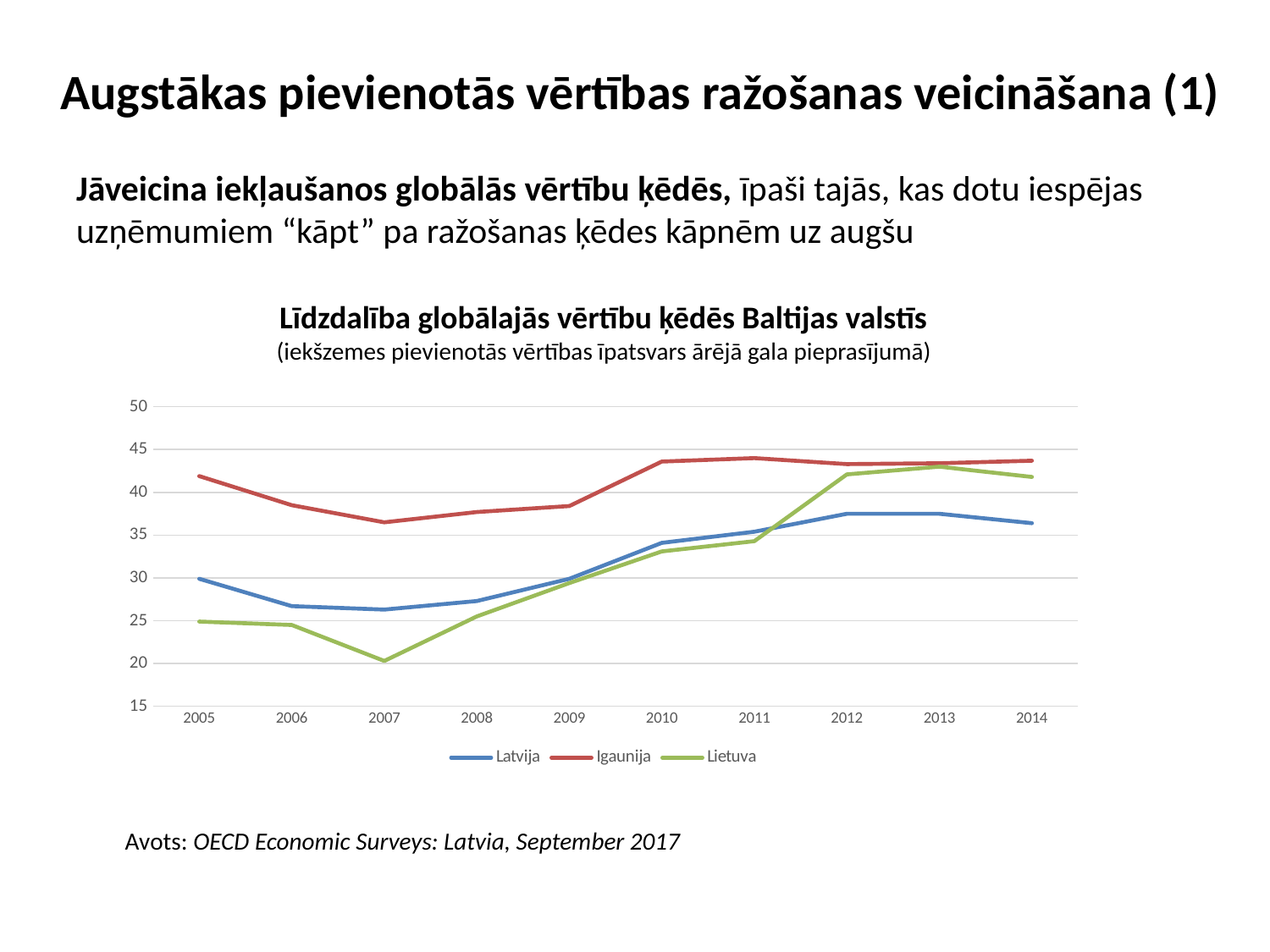
Which series has the highest value in 2005? Igaunija Which is larger in 2010, the value for Igaunija or the value for Latvija? Igaunija Is the value for Latvija in 2012 greater or less than 35? greater Which series has the lowest value in 2007? Lietuva Does the Lietuva line rise or fall between 2007 and 2013? rise Is the value for Igaunija in 2005 greater or less than 40? greater What kind of chart is shown on the slide? line chart What is the title of the chart? Līdzdalība globālajās vērtību ķēdēs Baltijas valstīs Which is larger in 2012, the value for Latvija or the value for Lietuva? Lietuva How many years are plotted along the x axis? 10 How many series does the legend list? 3 Is the value for Lietuva in 2007 greater or less than 25? less